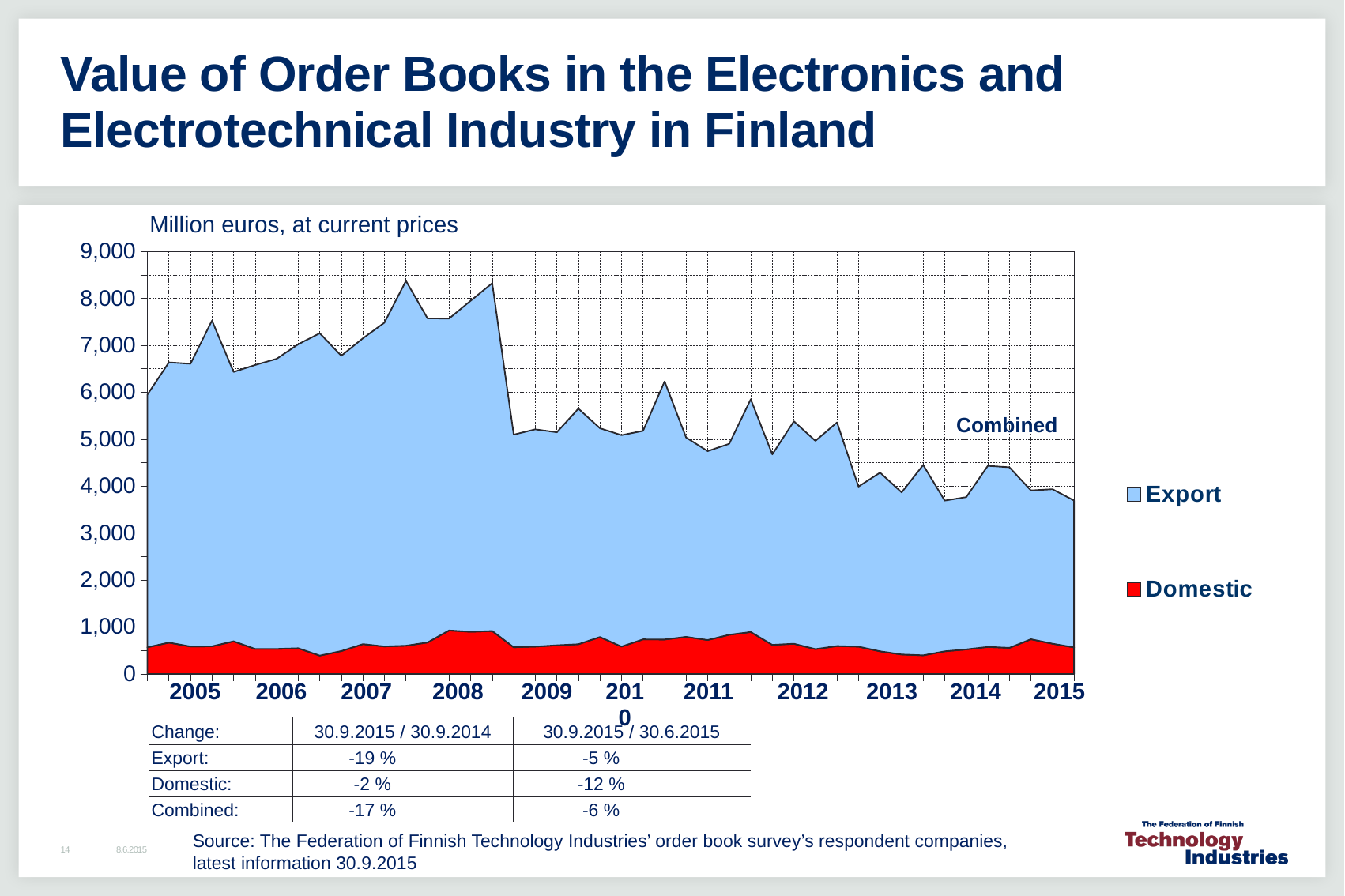
According to the change table, what is the Export change for 30.9.2015 / 30.9.2014? -19 % How many series does the legend list? 2 In what units are the values on the chart expressed, according to the label above the chart? Million euros, at current prices Is the Domestic value in 2008 greater or less than 1,000? less How many years are labelled on the x axis? 11 Is the Combined value at the start of 2005 greater or less than 5,000? greater What kind of chart is shown on the slide? Area chart Is the peak Combined value in 2008 greater or less than 8,000? greater Do the Combined values generally rise or fall from 2008 to 2015? fall Which two series are listed in the chart legend? Export and Domestic Which series is larger in 2015, Export or Domestic? Export